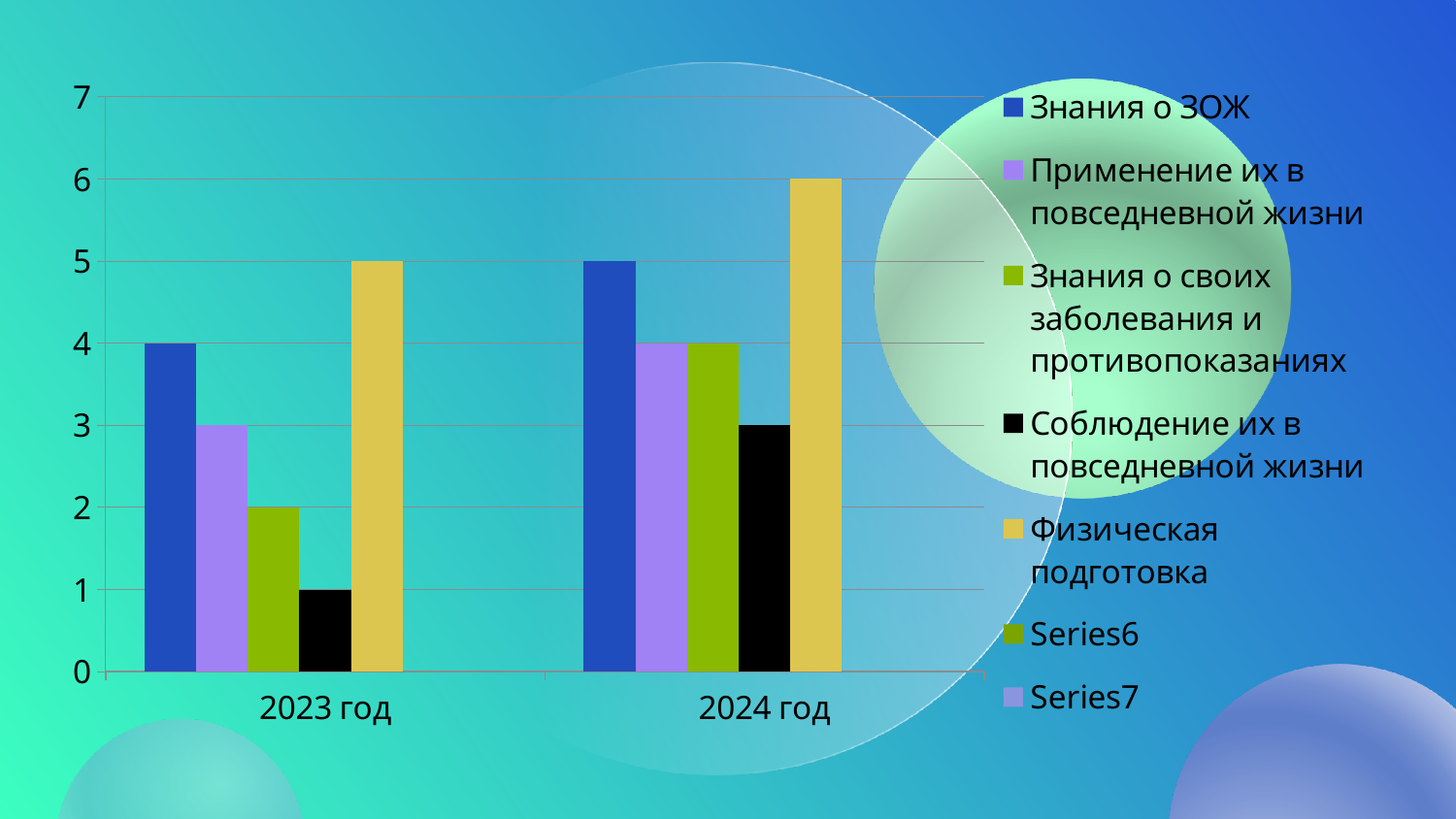
What is the difference between the values for Знания о ЗОЖ in 2024 год and 2023 год? 1 What is the value for Соблюдение их в повседневной жизни in 2023 год? 1 What kind of chart is shown on the slide? bar chart Does the value for Знания о ЗОЖ rise or fall from 2023 год to 2024 год? rise How many series does the legend list? 7 What is the value for Знания о ЗОЖ in 2023 год? 4 What is the value for Знания о своих заболевания и противопоказаниях in 2024 год? 4 What is the value for Физическая подготовка in 2024 год? 6 Which series has the highest value in 2023 год? Физическая подготовка Which is larger: Применение их в повседневной жизни in 2023 год or in 2024 год? 2024 год Which series has the lowest value in 2024 год? Соблюдение их в повседневной жизни How many categories are shown on the x axis? 2